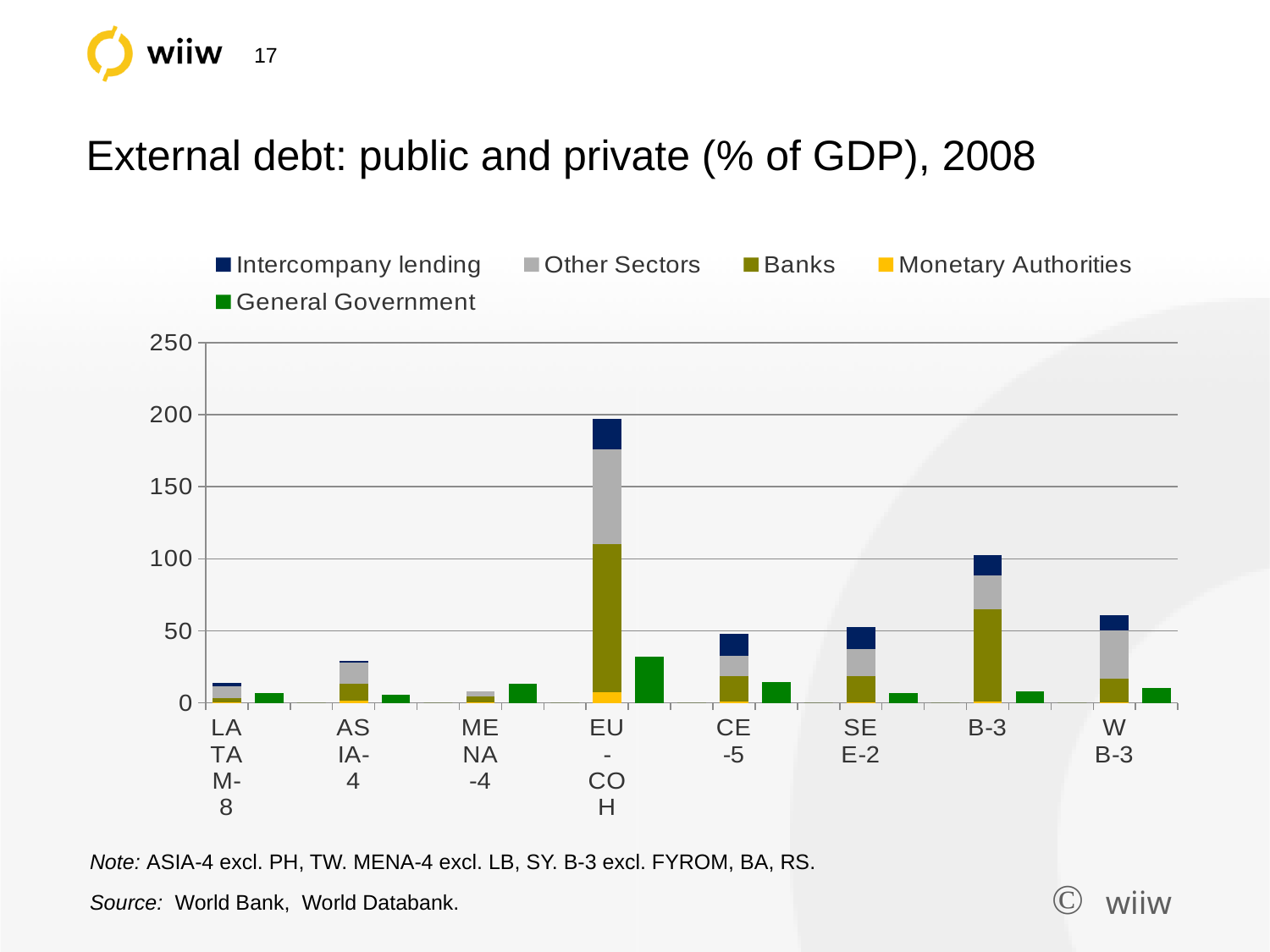
What is the title of the chart? External debt: public and private (% of GDP), 2008 How many country groups are shown on the x axis? 8 Which has the larger stacked bar, B-3 or WB-3? B-3 How many series does the legend list? 5 Is the total stacked bar for WB-3 greater or less than 50? greater Which country group has the shortest stacked bar? MENA-4 Is the General Government bar for EU-COH greater or less than 50? less Which country group has the tallest stacked bar? EU-COH Is the total stacked bar for EU-COH greater or less than 150? greater Which country group has the highest General Government bar? EU-COH What kind of chart is shown on the slide? Stacked bar chart